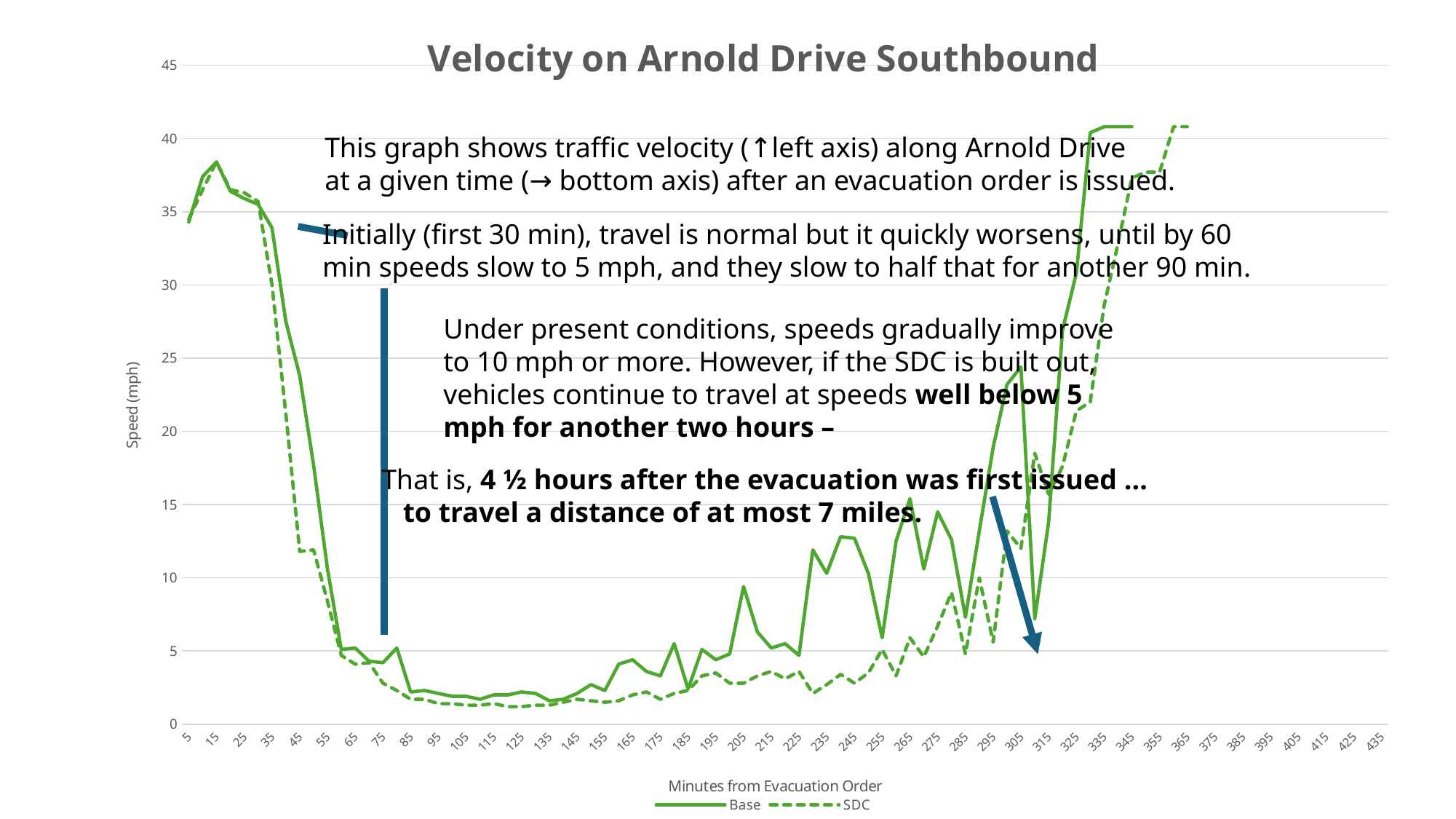
Is the Base value at 105 minutes greater or less than 5? less Is the Base value at 15 minutes greater or less than 35? greater How many series does the legend list? 2 Is the SDC value at 355 minutes greater or less than 30? greater What are the two series named in the legend? Base and SDC What kind of chart is shown on the slide? line chart At 305 minutes, which series has the higher speed, Base or SDC? Base Between 35 and 65 minutes, does the Base series rise or fall? fall Which series is drawn with a dashed line? SDC At 235 minutes, which series has the higher speed, Base or SDC? Base